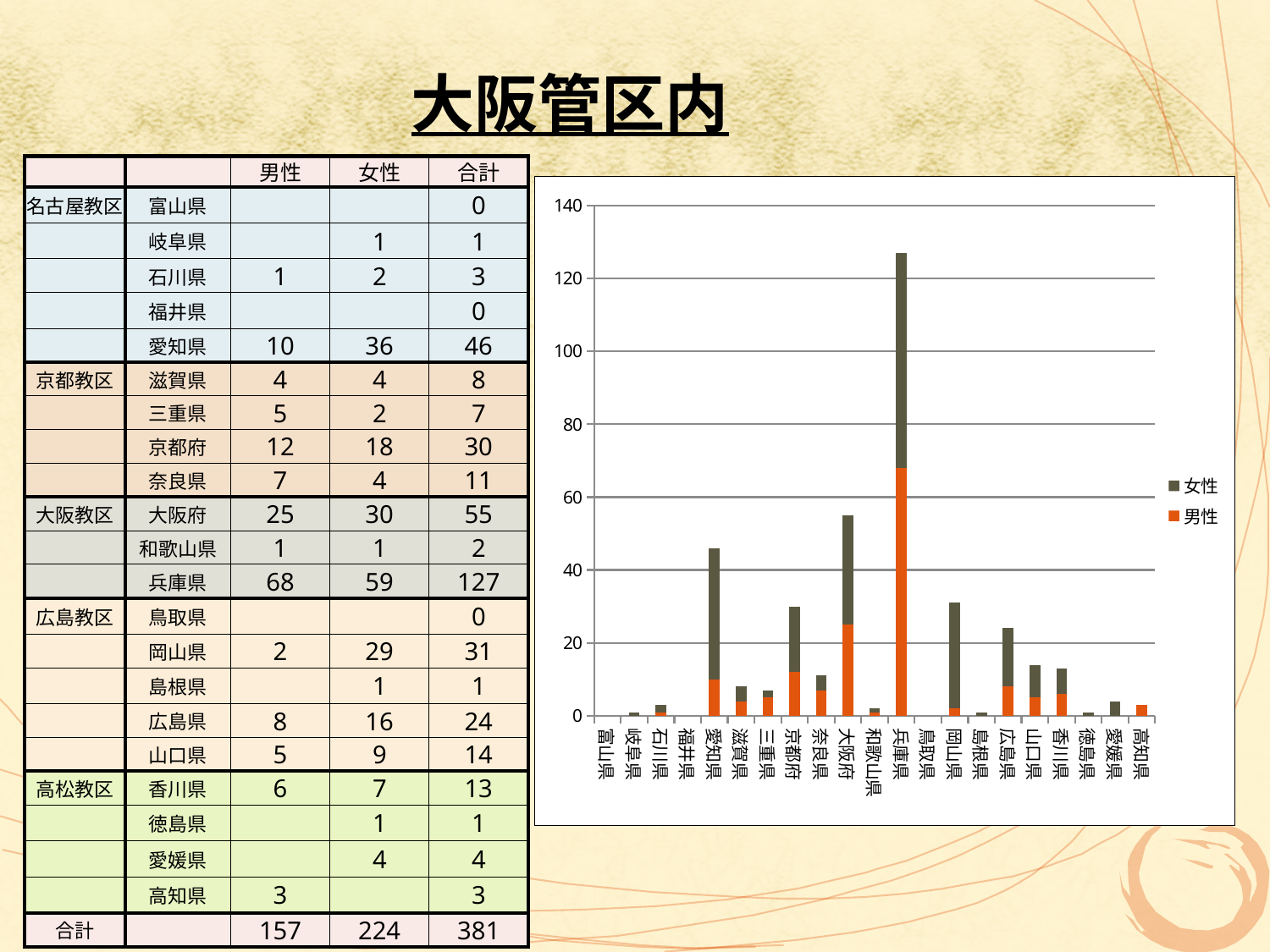
Which bar is taller in the chart, 広島県 or 山口県? 広島県 How many series does the chart's legend list? 2 Which prefecture has the tallest bar in the chart? 兵庫県 According to the table, what is the 男性 value for 兵庫県? 68 Is the total bar height for 岡山県 greater or less than 20? greater What are the two entries in the chart's legend? 女性, 男性 Which bar is taller in the chart, 大阪府 or 京都府? 大阪府 How many prefectures are shown along the x axis of the chart? 21 Is the total bar height for 兵庫県 greater or less than 120? greater Is the total bar height for 愛知県 greater or less than 40? greater What kind of chart is shown on the slide? bar chart What is the total (合計) for 兵庫県 shown in the table? 127